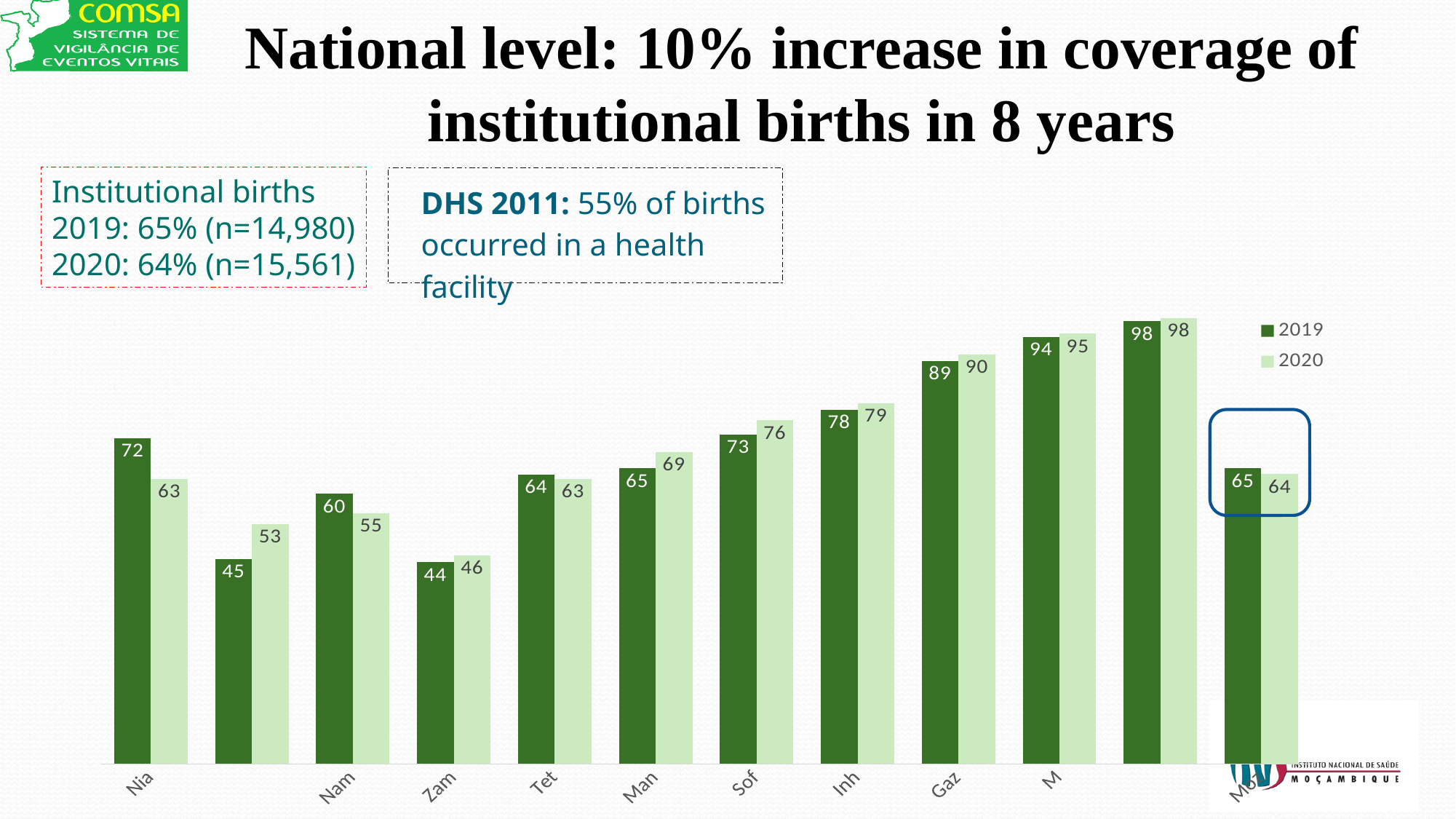
What is the 2019 value for Nia? 72 What is the 2020 value for Gaz? 90 Which is larger, the 2020 value for Inh or the 2020 value for Sof? Inh What is the 2019 value for Moz? 65 Which labelled category has the lowest 2019 value? Zam Which series is shown in dark green in the legend? 2019 What kind of chart is shown on the slide? Bar chart How many series does the legend list? 2 What is the difference between the 2019 and 2020 values for Nia? 9 Which is larger, the 2019 value for Nam or the 2020 value for Nam? 2019 What is the 2020 value for Sof? 76 What is the difference between the 2020 values for Man and Tet? 6